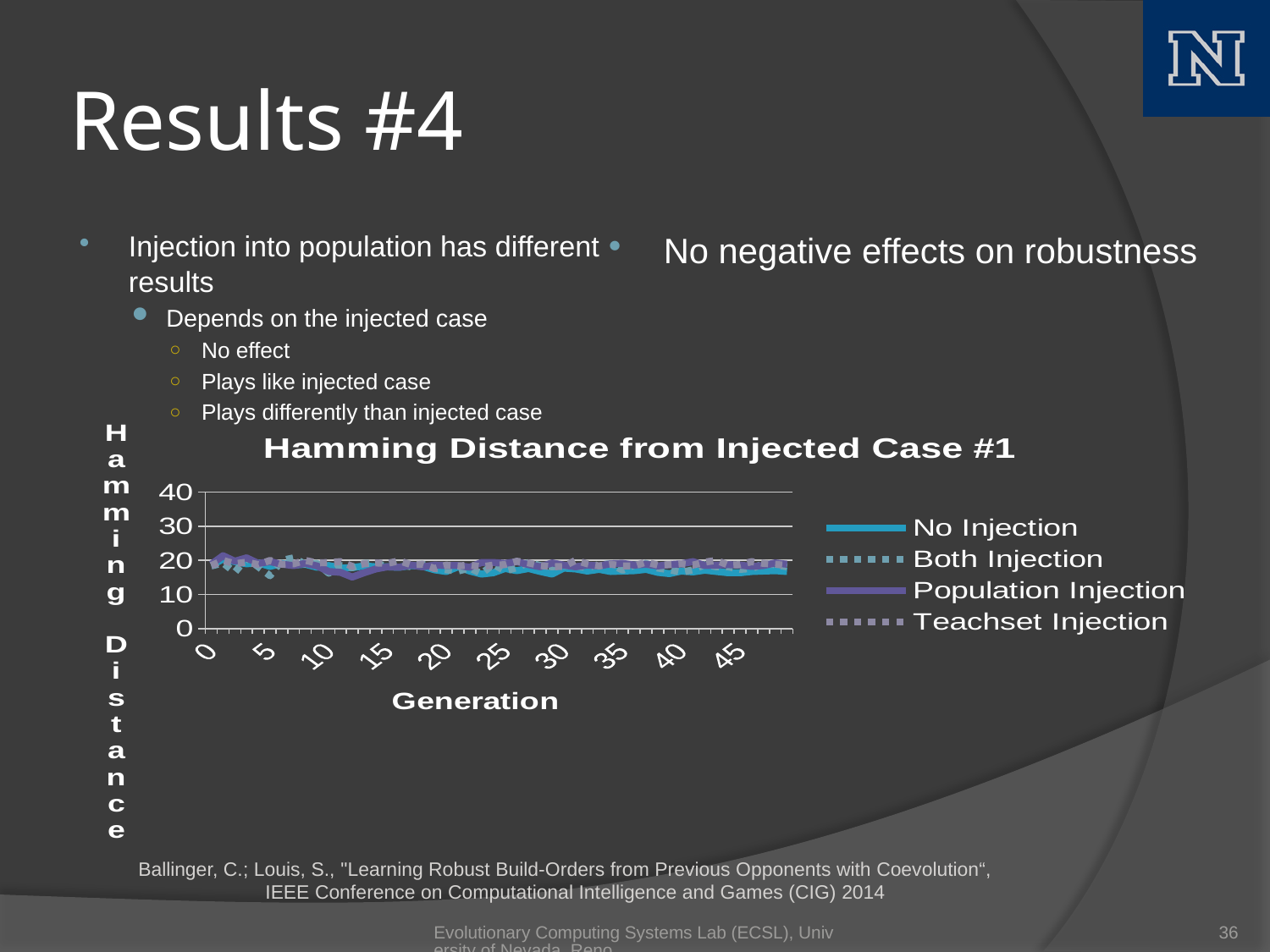
Which series are listed in the chart's legend? No Injection, Both Injection, Population Injection, Teachset Injection Is the value for Population Injection at generation 10 greater or less than 30? less What is the highest tick value shown on the y axis of the chart? 40 What kind of chart is shown on the slide? line chart Is the value for Both Injection at generation 30 greater or less than 10? greater Is the value for Teachset Injection at generation 40 greater or less than 10? greater What is the title of the chart? Hamming Distance from Injected Case #1 How many series does the chart's legend list? 4 What is the label of the x axis of the chart? Generation What is the highest labelled tick on the x axis of the chart? 45